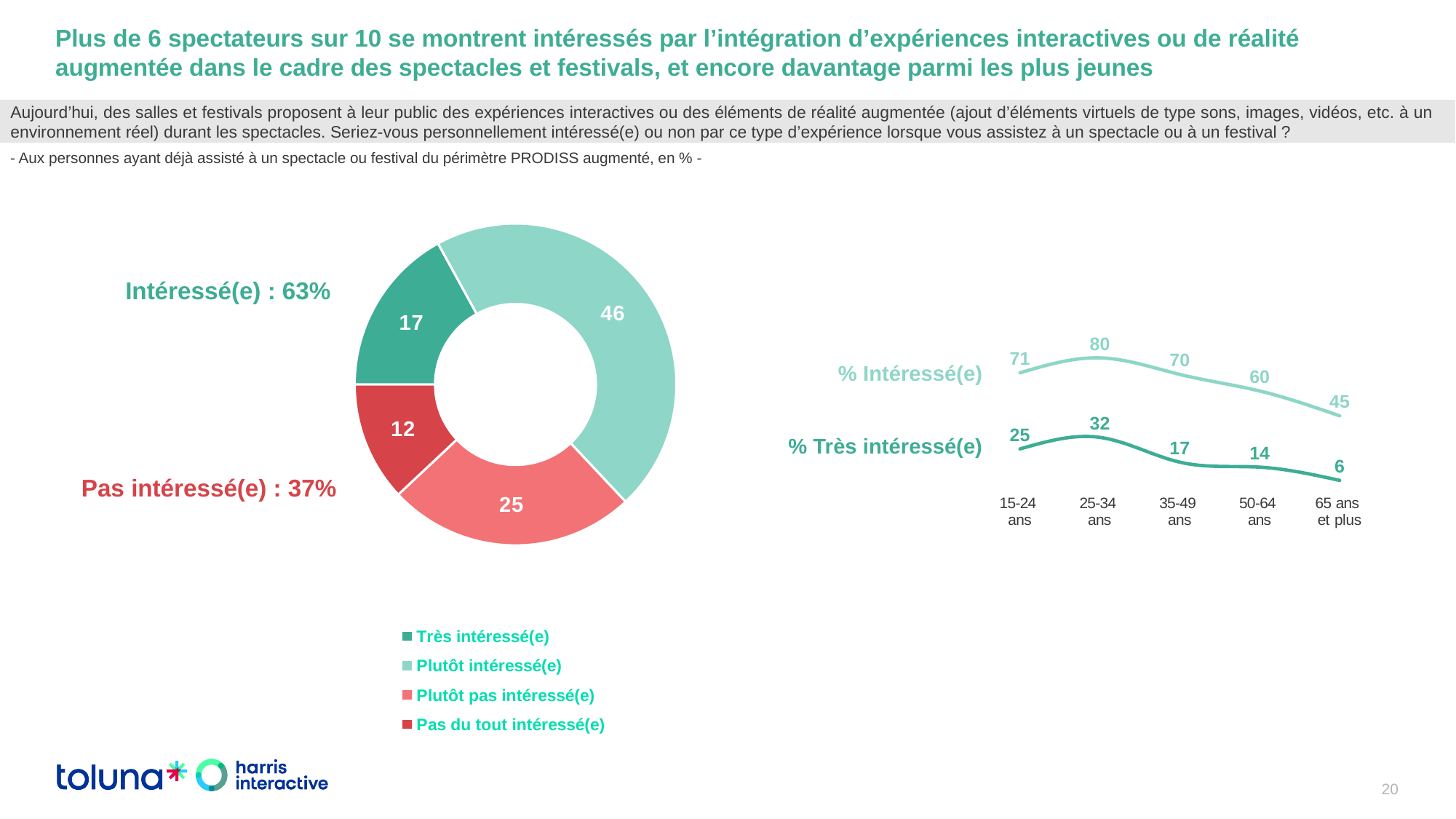
In the donut chart on the left, which category has the smallest share? Pas du tout intéressé(e) In the line chart on the right, how does "% Intéressé(e)" change from 25-34 ans to 65 ans et plus? It falls In the donut chart on the left, what is the difference between "Plutôt intéressé(e)" and "Plutôt pas intéressé(e)"? 21 In the donut chart on the left, what is the value for "Plutôt intéressé(e)"? 46 In the donut chart on the left, what total percentage is shown for "Intéressé(e)"? 63% In the line chart on the right, how many series are plotted? 2 In the line chart on the right, which age group has the highest "% Intéressé(e)" value? 25-34 ans In the line chart on the right, what is the "% Très intéressé(e)" value for 65 ans et plus? 6 In the line chart on the right, what is the "% Intéressé(e)" value for 25-34 ans? 80 In the donut chart on the left, what is the value for "Pas du tout intéressé(e)"? 12 In the donut chart on the left, how many categories does the legend list? 4 In the donut chart on the left, which category has the largest share? Plutôt intéressé(e)